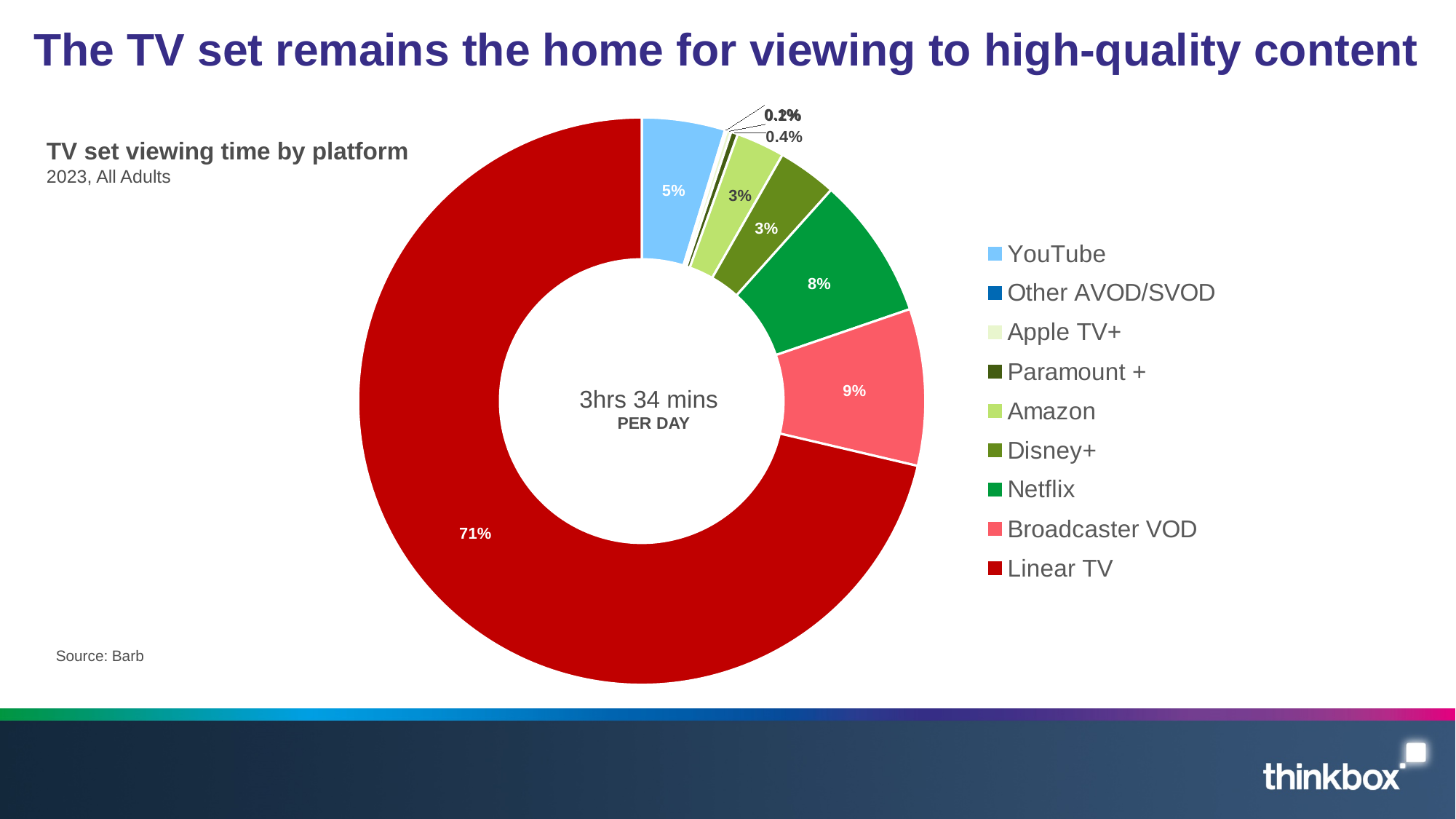
What total daily viewing time is shown in the centre of the donut chart? 3hrs 34 mins per day What share of TV set viewing time does Linear TV account for? 71% What share of TV set viewing time does Netflix account for? 8% What share of TV set viewing time does Broadcaster VOD account for? 9% What share of TV set viewing time does Amazon account for? 3% How many platforms are listed in the chart's legend? 9 Which platform has the largest share of TV set viewing time? Linear TV How many percentage points larger is Netflix's share than YouTube's share? 3 percentage points What kind of chart is shown on the slide? pie chart (donut) How many percentage points larger is Linear TV's share than Broadcaster VOD's share? 62 percentage points What share of TV set viewing time does YouTube account for? 5% Which has a larger share of TV set viewing time, Netflix or Broadcaster VOD? Broadcaster VOD